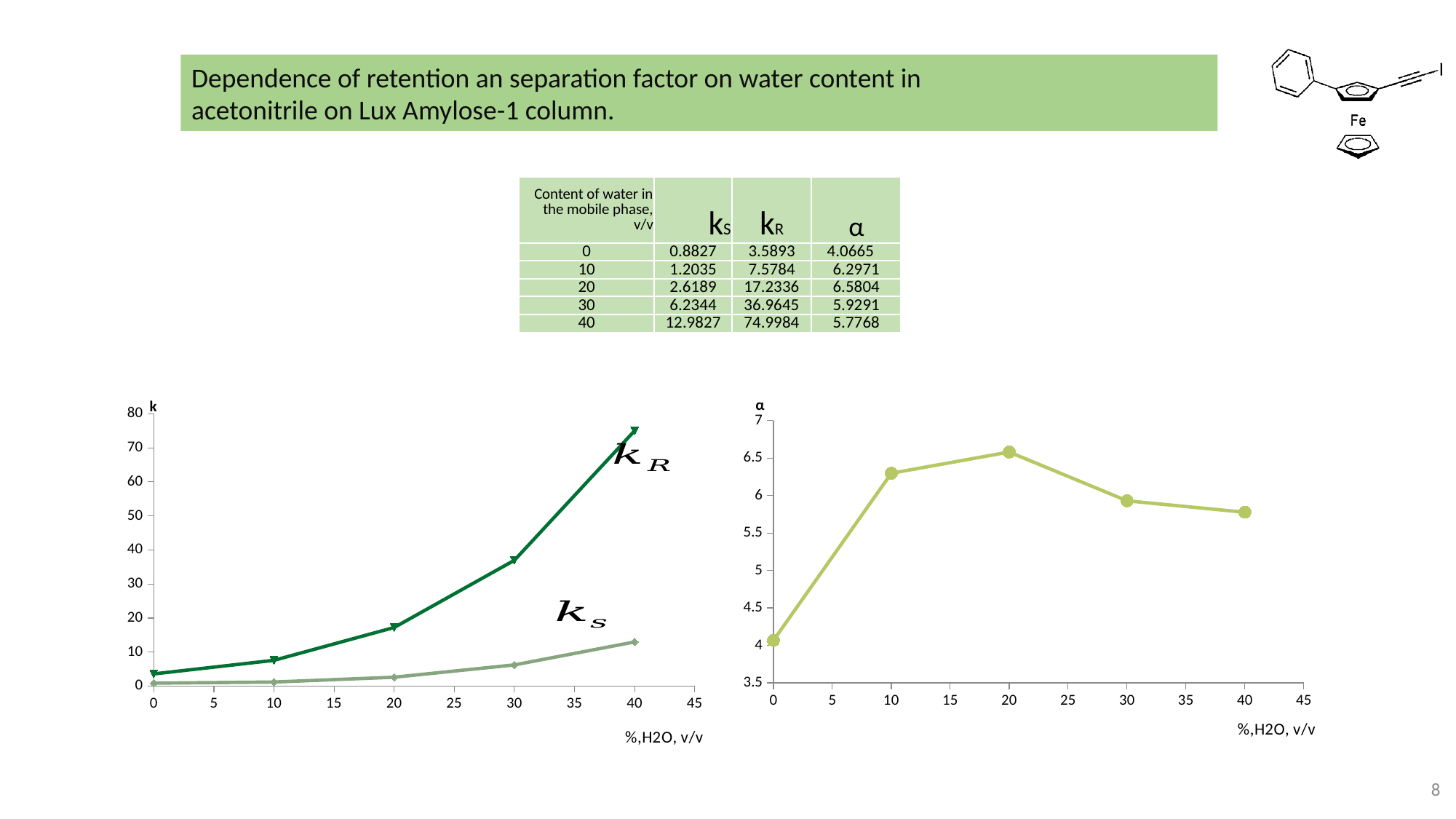
In the left chart (k versus %,H2O), how many series are plotted? 2 What kind of chart is the left chart (k versus %,H2O)? line chart According to the table on the slide, what is the value of α at 20 %,H2O? 6.5804 In the right chart, at which water content is α highest? 20 In the left chart, is the value of kR at 40 %,H2O greater or less than 70? greater In the left chart, does kR rise or fall as the water content increases from 0 to 40? rise In the right chart (α versus %,H2O), how many data points are plotted? 5 What is the x-axis label of the right chart (α chart)? %,H2O, v/v In the right chart, at which water content is α lowest? 0 In the right chart, is the value of α at 40 %,H2O greater or less than 6? less In the left chart, is the value of kS at 40 %,H2O greater or less than 20? less In the left chart, at 30 %,H2O, which series has the larger value, kR or kS? kR